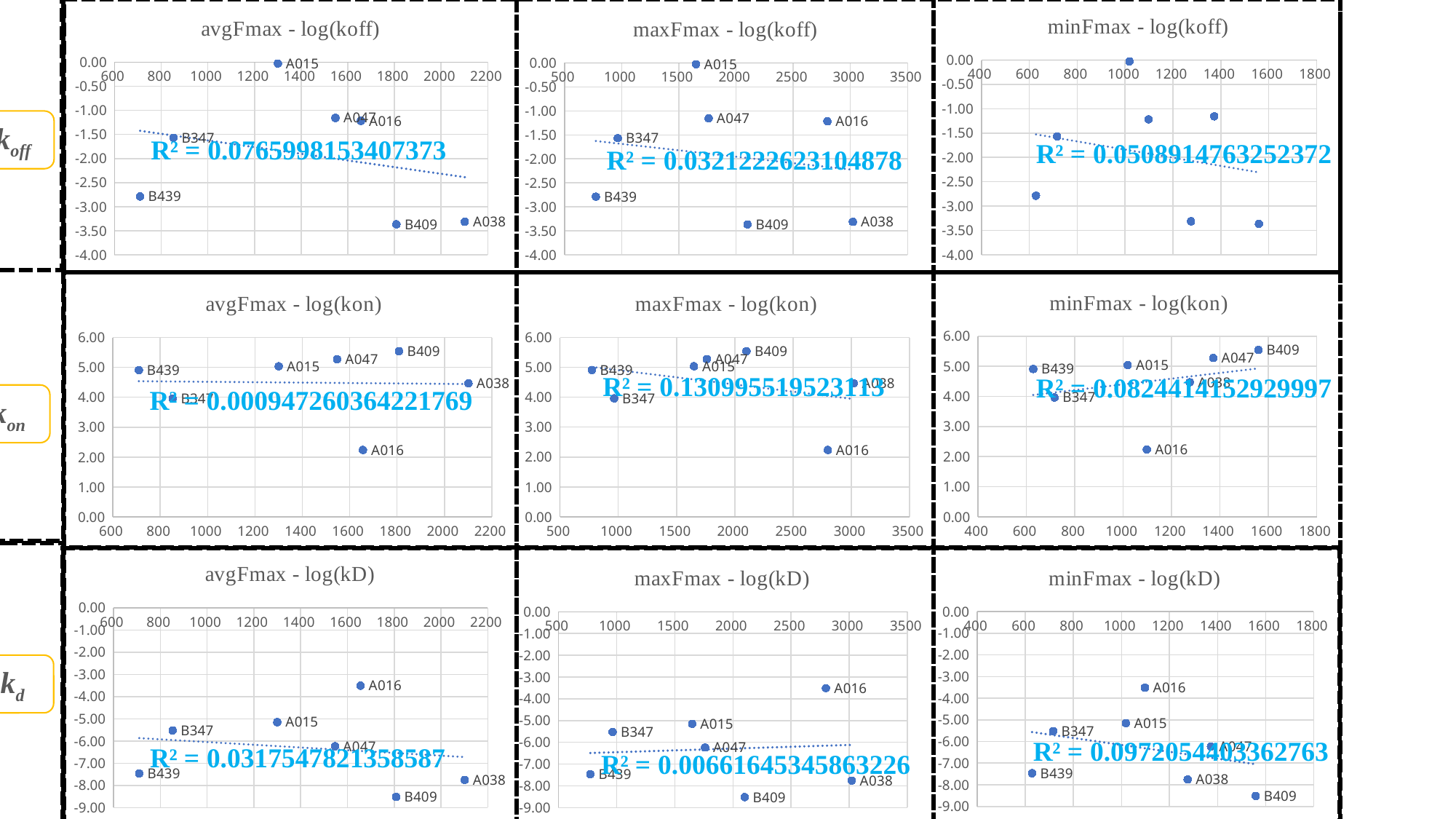
How many data points are plotted in the avgFmax - log(koff) chart? 7 In the avgFmax - log(kon) chart, which has the larger y value, A015 or A016? A015 In the maxFmax - log(kon) chart, what R² value is printed? R² = 0.130995519523113 In the avgFmax - log(koff) chart, which labelled point has the highest y value? A015 In the avgFmax - log(koff) chart, what R² value is printed? R² = 0.0765998153407373 How many charts are shown on the slide? 9 What kind of chart is the avgFmax - log(koff) chart? scatter chart In the avgFmax - log(kD) chart, which labelled point has the highest y value? A016 In the avgFmax - log(koff) chart, is the y value for B439 greater or less than -2.50? less In the minFmax - log(kD) chart, is the y value for B409 greater or less than -8.00? less In the avgFmax - log(kD) chart, which labelled point has the lowest y value? B409 In the avgFmax - log(kon) chart, which labelled point has the lowest y value? A016